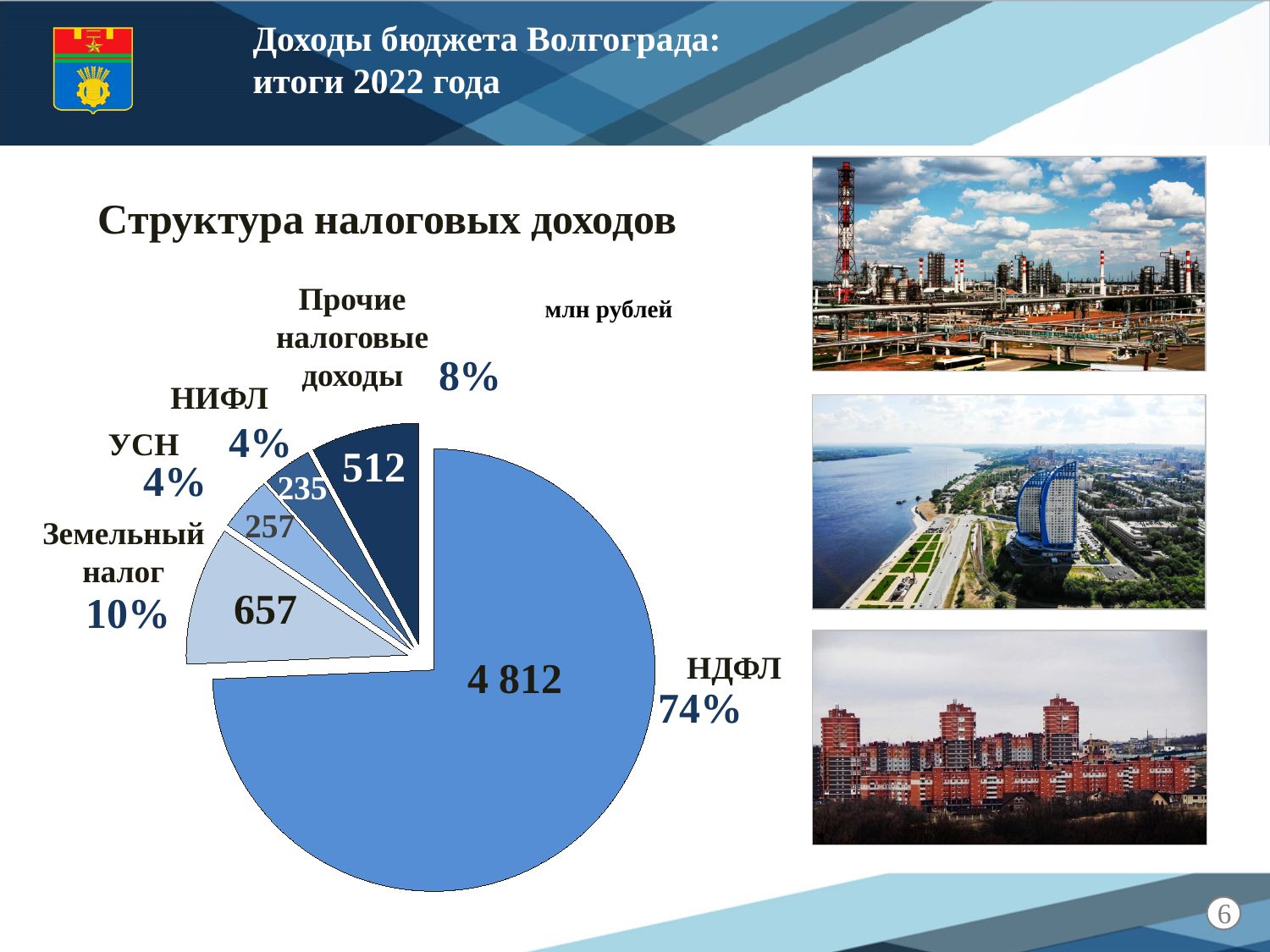
How many slices does the pie chart have? 5 What share of the pie does Земельный налог account for? 10% What share of the pie does Прочие налоговые доходы account for? 8% Which is larger in the pie chart: Земельный налог or Прочие налоговые доходы? Земельный налог What is the value for НДФЛ in the pie chart? 4 812 What share of the pie does НДФЛ account for? 74% Which category has the largest slice in the pie chart? НДФЛ What is the difference between the values for НДФЛ and Земельный налог? 4 155 What is the value for Земельный налог in the pie chart? 657 What is the value for Прочие налоговые доходы in the pie chart? 512 What kind of chart is shown under the heading "Структура налоговых доходов"? pie chart In what units are the values in the pie chart given? млн рублей